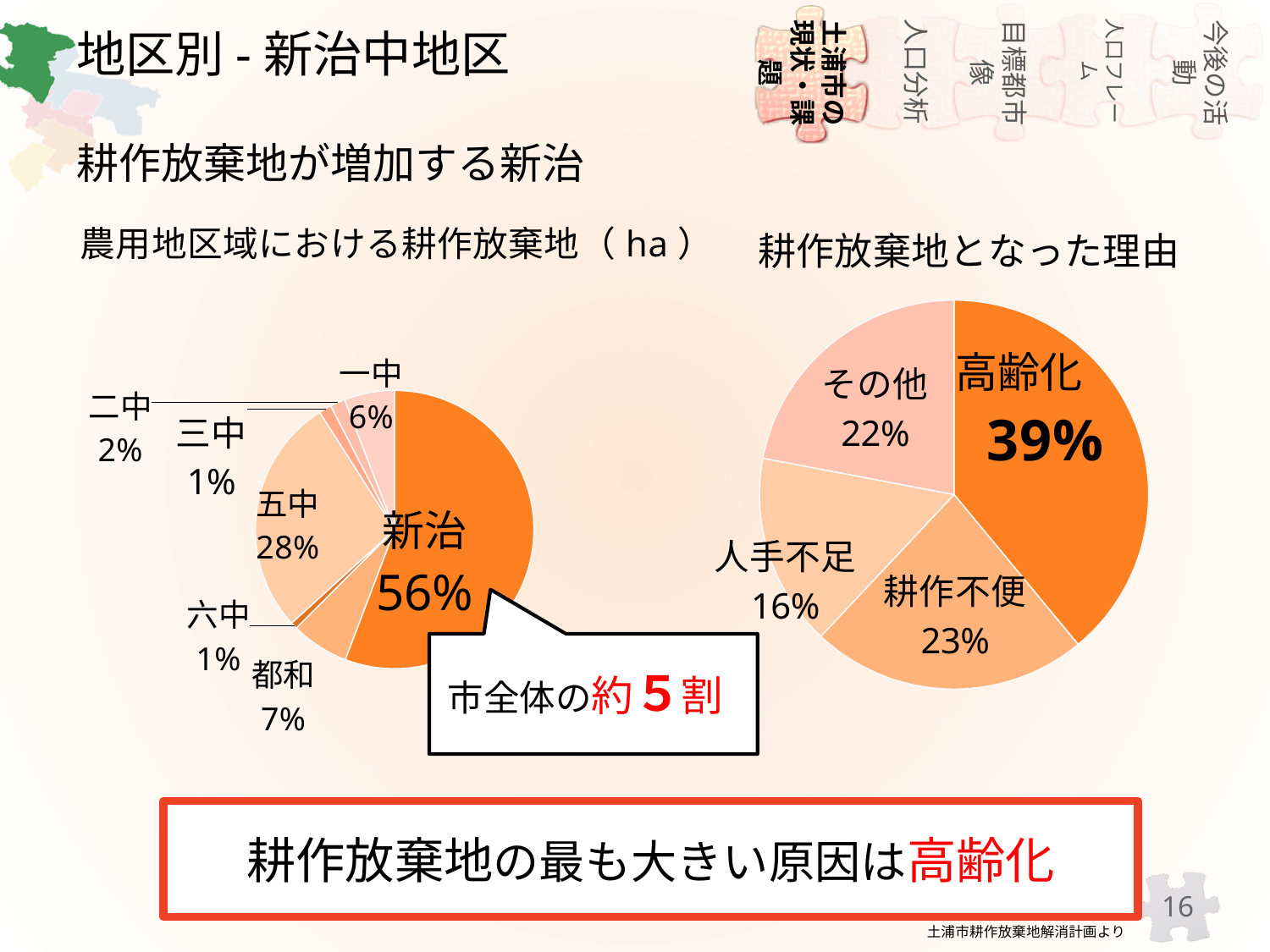
In the pie chart titled 農用地区域における耕作放棄地（ha）, what share does 五中 have? 28% In the pie chart titled 農用地区域における耕作放棄地（ha）, what share does 新治 have? 56% In the pie chart titled 耕作放棄地となった理由, what is the difference between the shares of 耕作不便 and その他? 1% In the pie chart titled 農用地区域における耕作放棄地（ha）, which is larger, the share of 都和 or the share of 一中? 都和 In the pie chart titled 耕作放棄地となった理由, what share is attributed to 高齢化? 39% In the pie chart titled 耕作放棄地となった理由, which reason has the smallest share? 人手不足 In the pie chart titled 農用地区域における耕作放棄地（ha）, how many slices are there? 7 What type of chart is used for 耕作放棄地となった理由? Pie chart In the pie chart titled 農用地区域における耕作放棄地（ha）, what is the difference between the shares of 新治 and 五中? 28% In the pie chart titled 耕作放棄地となった理由, how many reasons are shown? 4 In the pie chart titled 耕作放棄地となった理由, what share is attributed to 人手不足? 16% In the pie chart titled 農用地区域における耕作放棄地（ha）, which district has the largest share? 新治